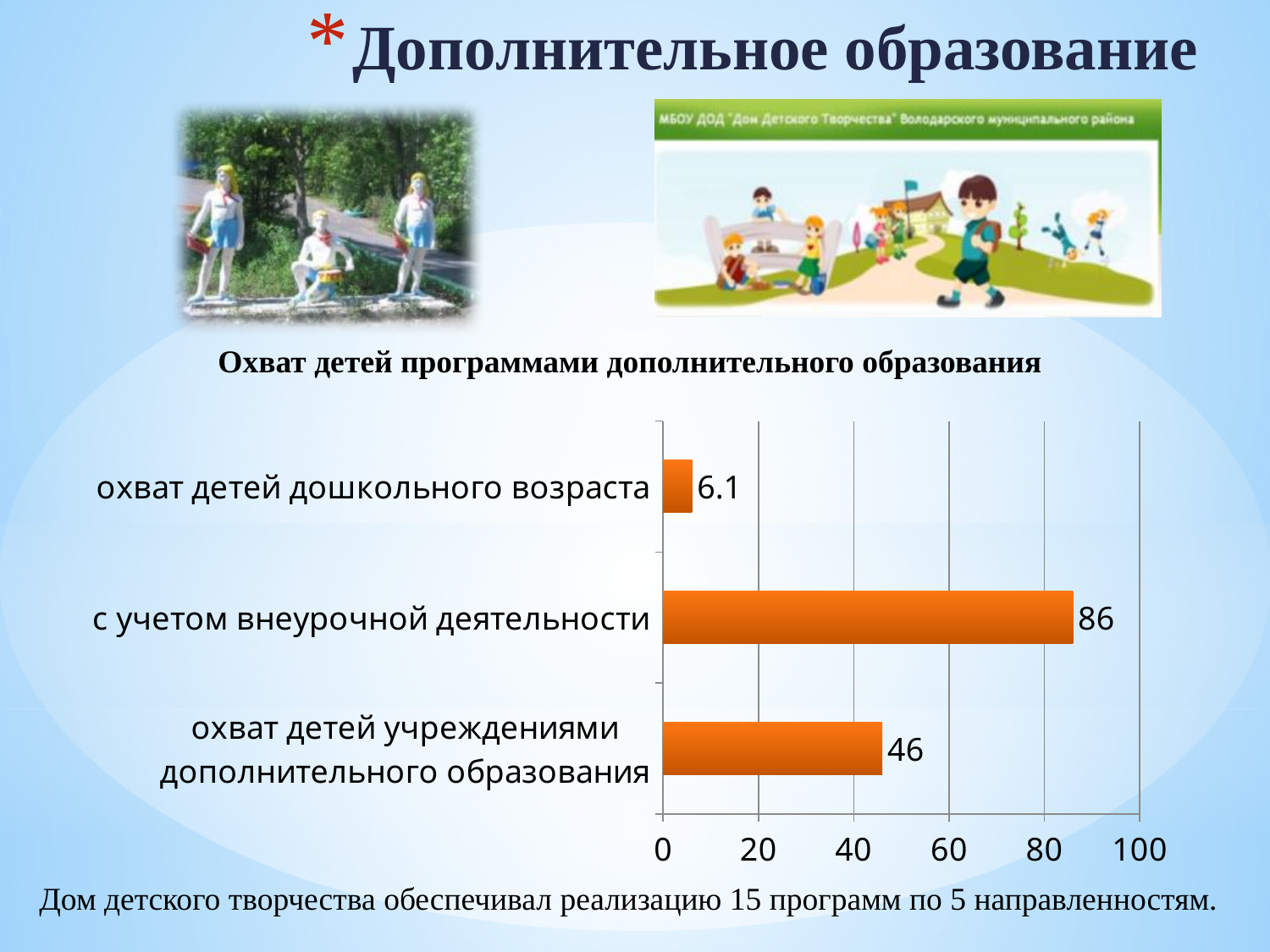
What is the value for 'с учетом внеурочной деятельности'? 86 What kind of chart is shown on the slide? bar chart What is the value for 'охват детей дошкольного возраста'? 6.1 Which is larger: the value for 'охват детей учреждениями дополнительного образования' or for 'охват детей дошкольного возраста'? охват детей учреждениями дополнительного образования What is the title of the chart? Охват детей программами дополнительного образования Which category has the lowest value? охват детей дошкольного возраста How many categories are shown in the chart? 3 Which category has the highest value? с учетом внеурочной деятельности What is the value for 'охват детей учреждениями дополнительного образования'? 46 Is the value for 'с учетом внеурочной деятельности' greater or less than 80? greater What is the difference between the values for 'охват детей учреждениями дополнительного образования' and 'охват детей дошкольного возраста'? 39.9 What is the difference between the values for 'с учетом внеурочной деятельности' and 'охват детей учреждениями дополнительного образования'? 40